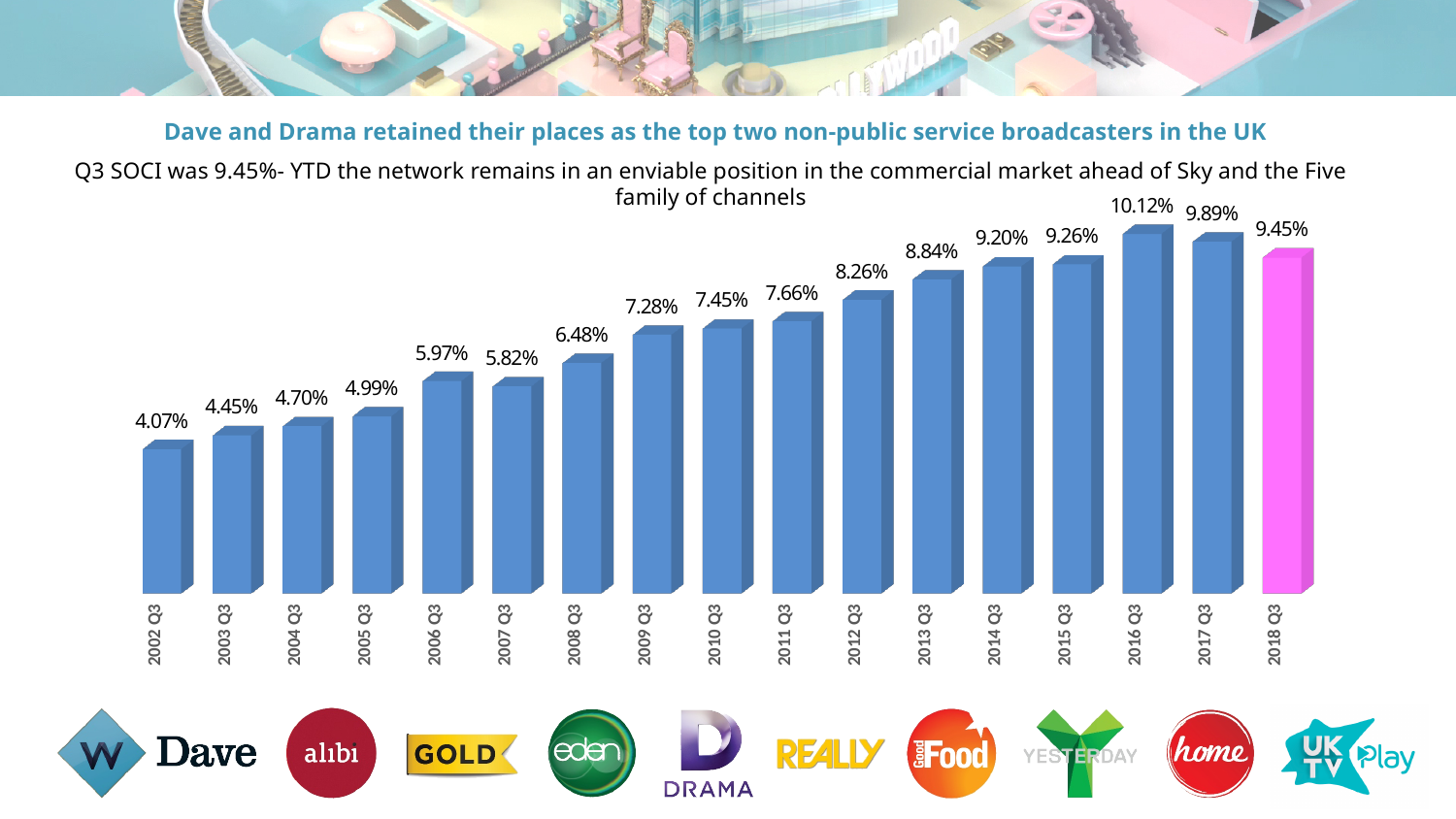
Which is larger, the value for 2006 Q3 or the value for 2007 Q3? 2006 Q3 What is the value for 2018 Q3? 9.45% What is the difference between the values for 2016 Q3 and 2018 Q3? 0.67% How many quarters are shown on the x axis? 17 Which is larger, the value for 2017 Q3 or the value for 2018 Q3? 2017 Q3 What is the value for 2012 Q3? 8.26% Which quarter has the lowest value? 2002 Q3 Which quarter has the highest value? 2016 Q3 What kind of chart is shown on the slide? Bar chart What is the difference between the values for 2006 Q3 and 2007 Q3? 0.15% Which bar is coloured differently from the others? 2018 Q3 What is the value for 2002 Q3? 4.07%